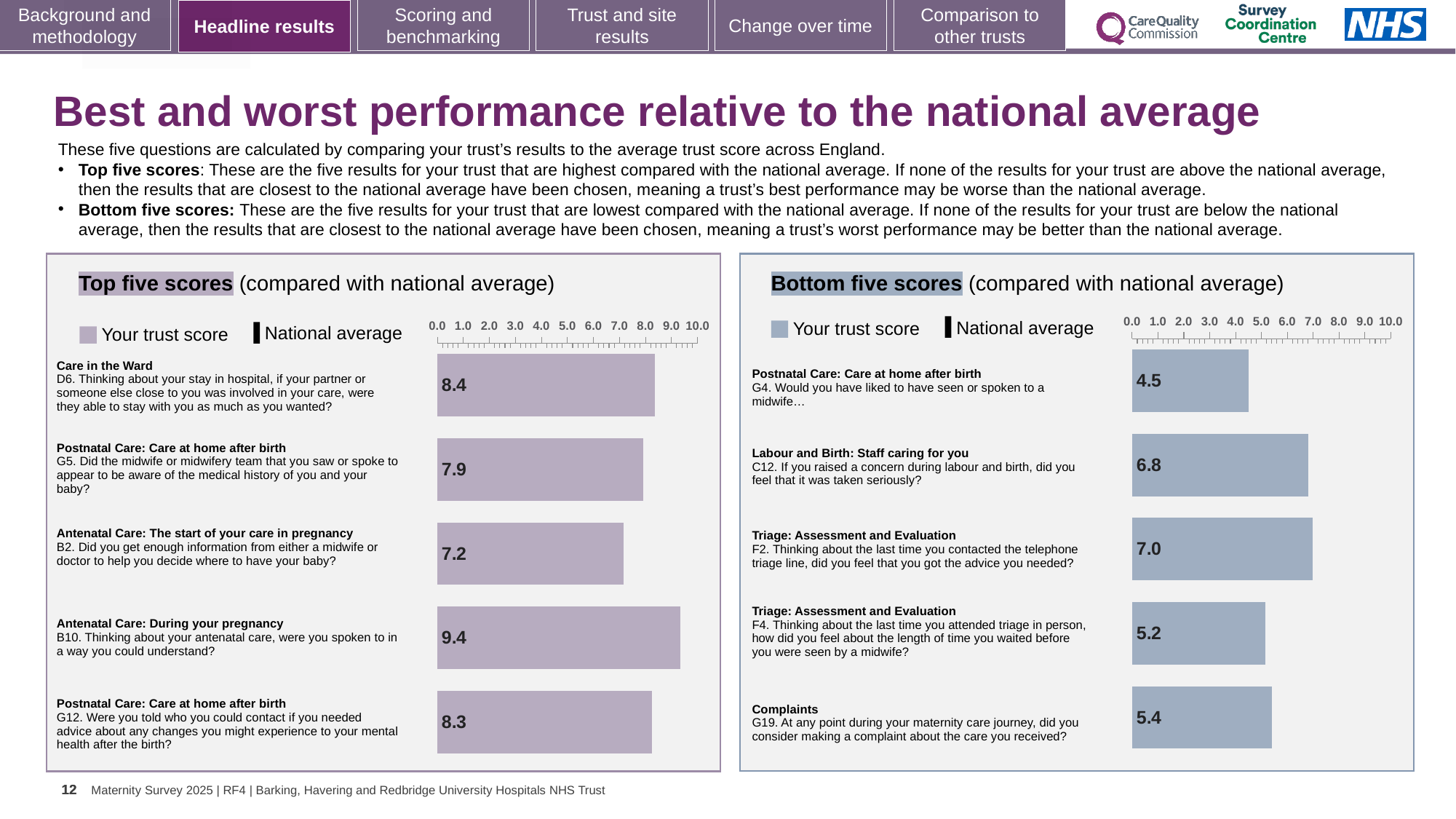
In the Top five scores chart, what is the difference between the highest score (B10) and the lowest score (B2)? 2.2 In the Top five scores chart, which question has the lowest trust score? B2 (Antenatal Care: The start of your care in pregnancy) How many questions are shown in the Bottom five scores chart? 5 In the Bottom five scores chart, which question has the lowest trust score? G4 (Postnatal Care: Care at home after birth) In the Bottom five scores chart, is the trust score for G4 greater or less than 5.0? less In the Bottom five scores chart, what is the trust score for question G4 (Postnatal Care: Care at home after birth)? 4.5 In the Bottom five scores chart, which question has the highest trust score? F2 (Triage: Assessment and Evaluation) In the Top five scores chart, what is the trust score for question D6 (Care in the Ward)? 8.4 In the Top five scores chart, which has the higher trust score: G5 or G12? G12 What type of chart is used in the Top five scores panel? Bar chart In the Bottom five scores chart, what is the difference between the scores for C12 and F4? 1.6 In the Top five scores chart, which question has the highest trust score? B10 (Antenatal Care: During your pregnancy)